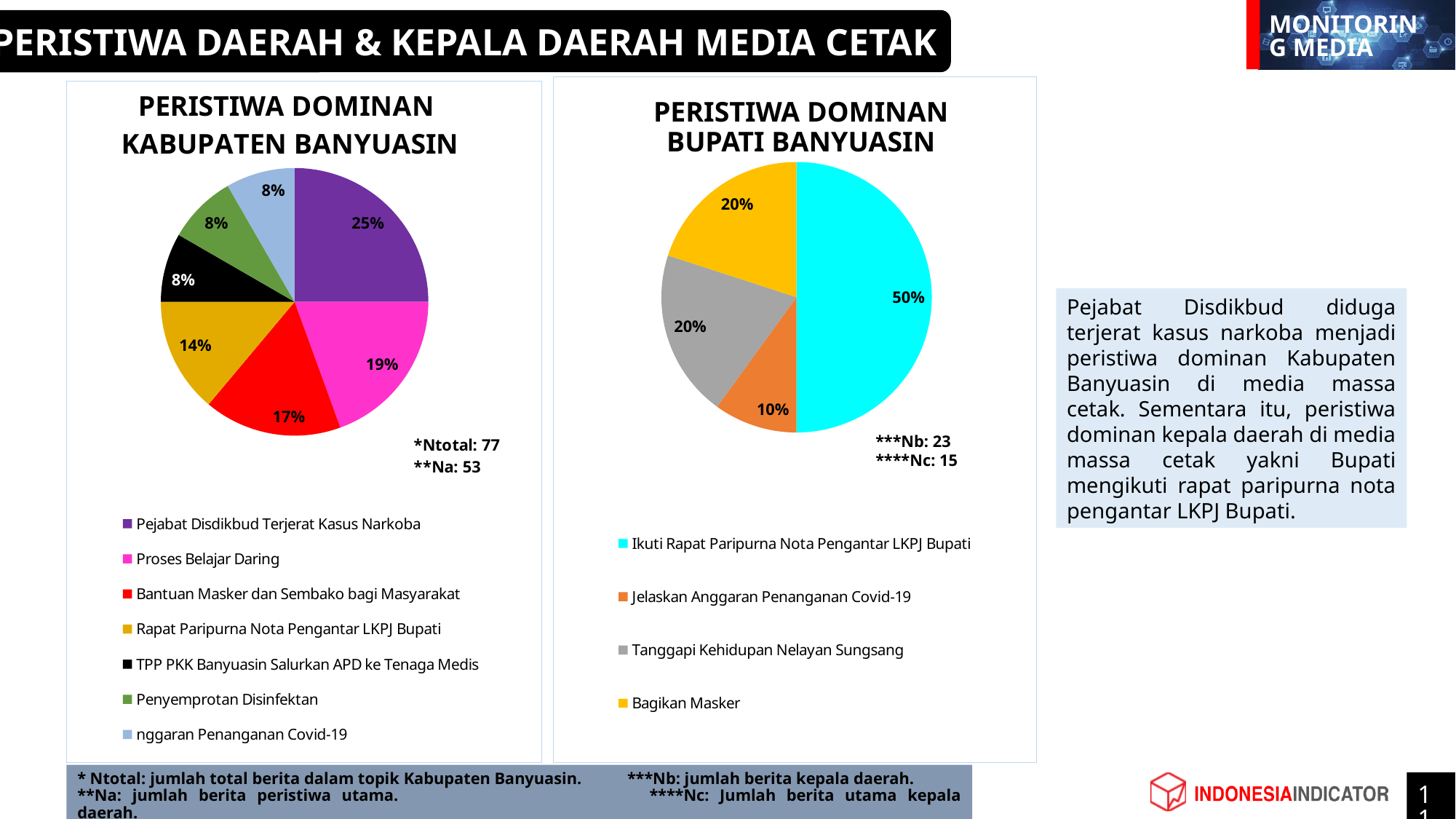
In the PERISTIWA DOMINAN KABUPATEN BANYUASIN chart, how many categories are shown? 7 In the PERISTIWA DOMINAN KABUPATEN BANYUASIN chart, what is the value for Rapat Paripurna Nota Pengantar LKPJ Bupati? 14% In the PERISTIWA DOMINAN KABUPATEN BANYUASIN chart, what share does Pejabat Disdikbud Terjerat Kasus Narkoba have? 25% In the PERISTIWA DOMINAN BUPATI BANYUASIN chart, which category has the smallest share? Jelaskan Anggaran Penanganan Covid-19 In the PERISTIWA DOMINAN KABUPATEN BANYUASIN chart, what is the difference between Proses Belajar Daring and Bantuan Masker dan Sembako bagi Masyarakat? 2% In the PERISTIWA DOMINAN KABUPATEN BANYUASIN chart, which category has the largest share? Pejabat Disdikbud Terjerat Kasus Narkoba In the PERISTIWA DOMINAN KABUPATEN BANYUASIN chart, what is the value for Proses Belajar Daring? 19% In the PERISTIWA DOMINAN BUPATI BANYUASIN chart, what share does Ikuti Rapat Paripurna Nota Pengantar LKPJ Bupati have? 50% What type of chart is the PERISTIWA DOMINAN BUPATI BANYUASIN chart? Pie chart In the PERISTIWA DOMINAN BUPATI BANYUASIN chart, which is larger: Tanggapi Kehidupan Nelayan Sungsang or Jelaskan Anggaran Penanganan Covid-19? Tanggapi Kehidupan Nelayan Sungsang In the PERISTIWA DOMINAN BUPATI BANYUASIN chart, what is the value for Jelaskan Anggaran Penanganan Covid-19? 10% In the PERISTIWA DOMINAN BUPATI BANYUASIN chart, how many categories does the legend list? 4